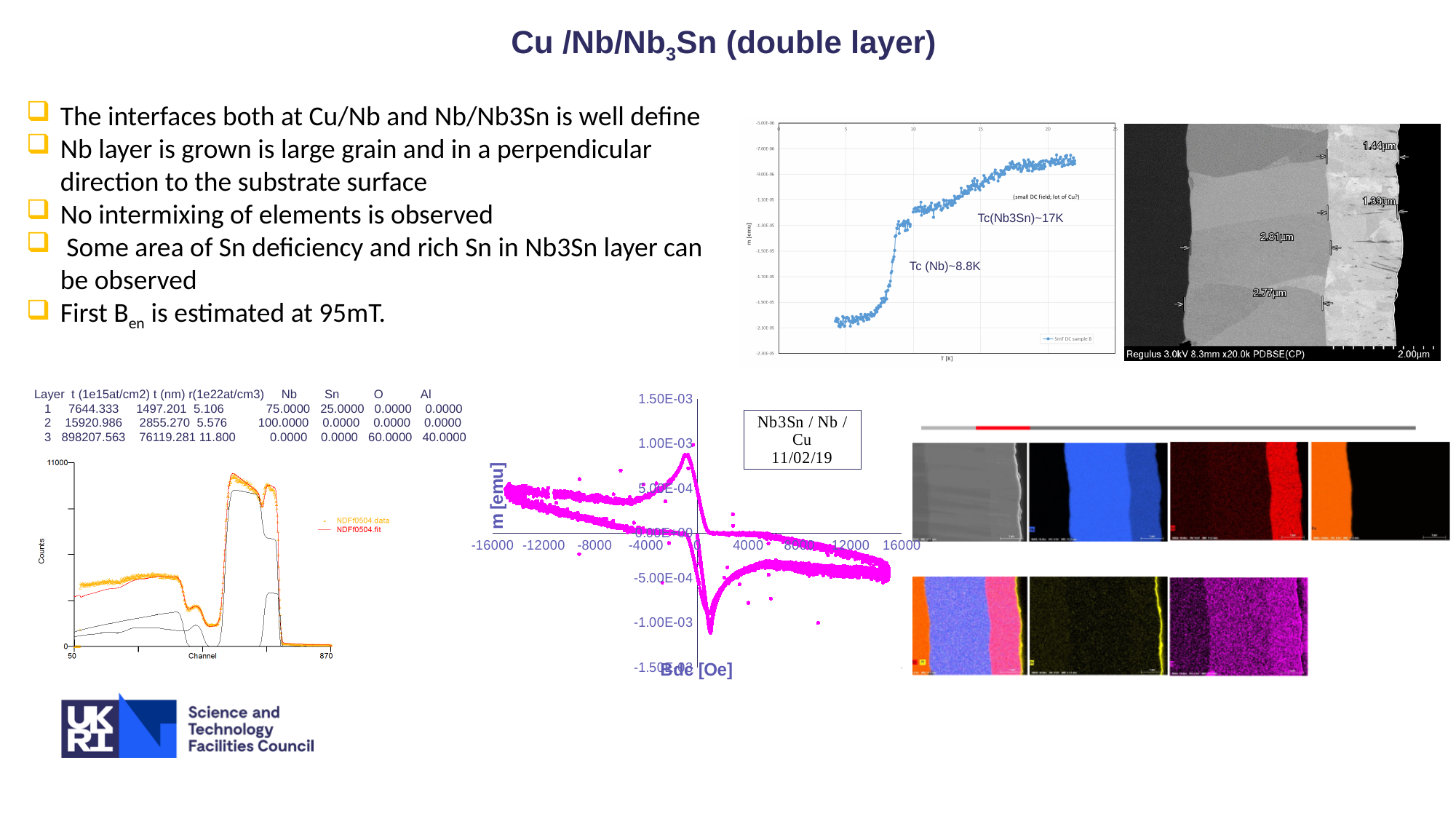
In the top-right chart of m [emu] versus T [K], what transition temperature is annotated for Nb3Sn? Tc(Nb3Sn)~17K In the hysteresis loop chart in the middle of the slide, what is the label on the x axis? Bdc [Oe] In the top-right chart of m [emu] versus T [K], do the plotted values rise or fall as temperature increases along the x axis? rise How many series does the legend of the bottom-left Counts versus Channel chart list? 2 In the top-right chart of m [emu] versus T [K], what transition temperature is annotated for Nb? Tc (Nb)~8.8K In the hysteresis loop chart in the middle of the slide, what is the lowest tick value shown on the x axis? -16000 What sample name and date are written in the text box next to the hysteresis loop chart? Nb3Sn / Nb / Cu 11/02/19 In the bottom-left Counts versus Channel chart, what is the highest channel value shown on the x axis? 870 In the bottom-left Counts versus Channel chart, what is the maximum value shown on the y axis? 11000 In the hysteresis loop chart in the middle of the slide, what is the highest value shown on the y axis? 1.50E-03 What kind of chart is the hysteresis loop chart in the middle of the slide? scatter chart How many series does the legend of the top-right chart of m [emu] versus T [K] list? 1